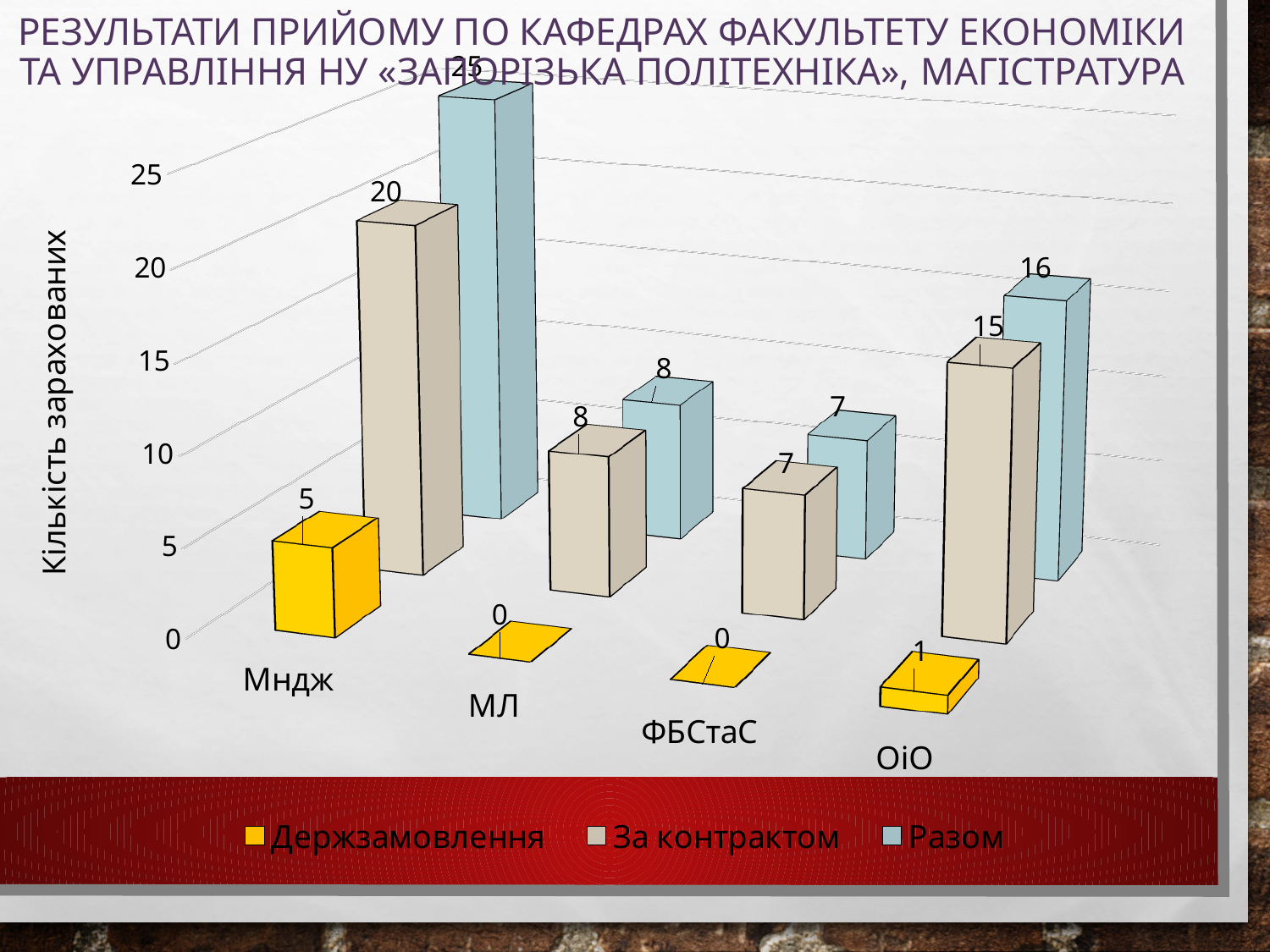
What is the difference between the Разом values for Мндж and ОіО? 9 Which category has the lowest За контрактом value? ФБСтаС What is the label of the vertical axis? Кількість зарахованих Which category has the highest Разом value? Мндж What kind of chart is shown on the slide? bar chart How many series does the legend list? 3 What is the value of Держзамовлення for МЛ? 0 What is the value of Держзамовлення for Мндж? 5 How many categories are shown on the x axis? 4 What is the value of За контрактом for ОіО? 15 What is the value of Разом for ФБСтаС? 7 Which is larger: За контрактом for МЛ or За контрактом for ОіО? ОіО